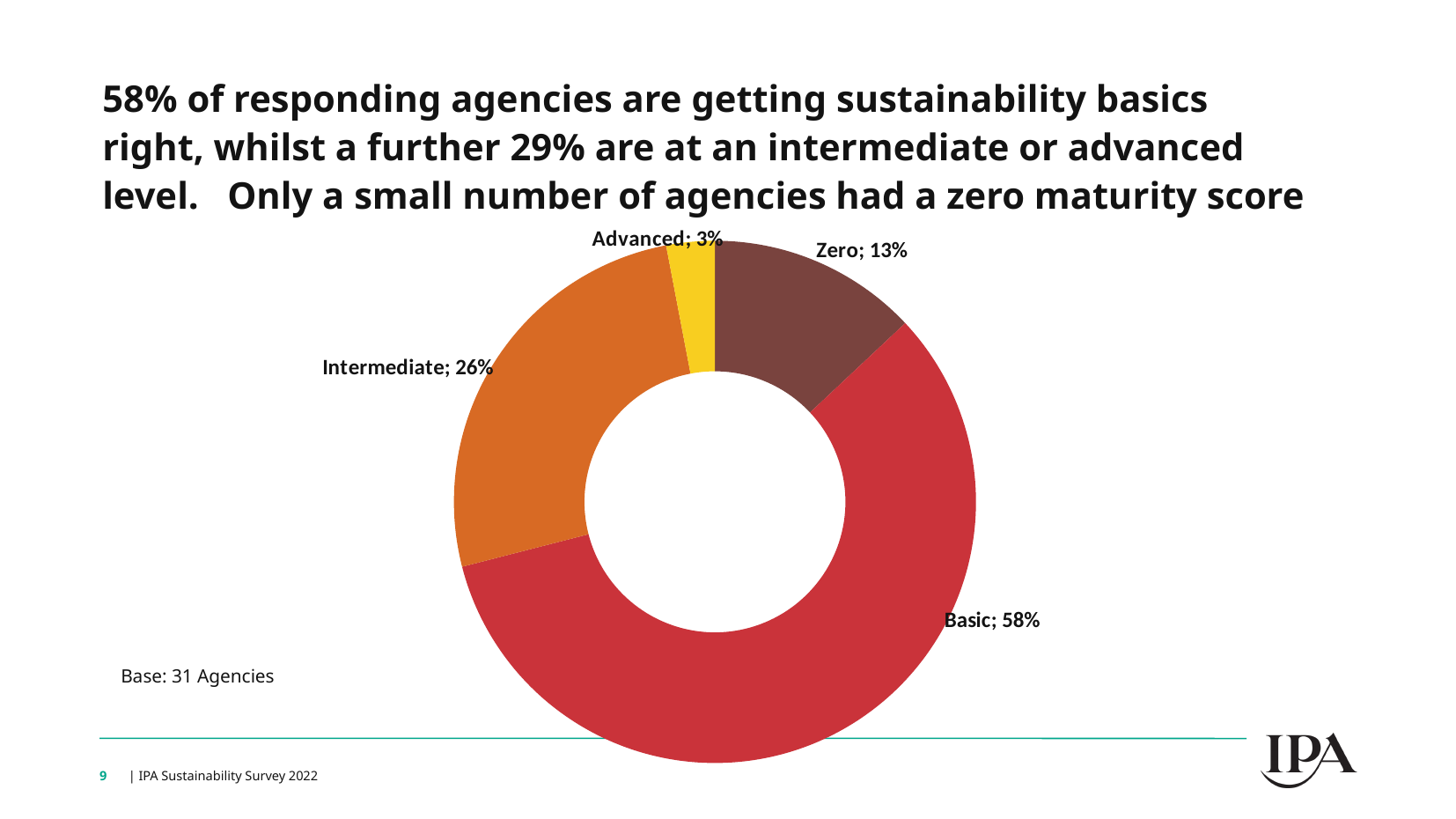
What is the difference in percentage points between the Basic and Intermediate shares? 32 Which maturity level has the smallest share of agencies? Advanced What percentage of agencies are at the Basic maturity level? 58% What kind of chart is shown on the slide? Doughnut chart What percentage of agencies are at the Intermediate maturity level? 26% How many maturity levels are shown in the chart? 4 Which maturity level has the largest share of agencies? Basic What is the difference in percentage points between the Zero and Advanced shares? 10 Which is larger, the share for Intermediate or the share for Zero? Intermediate What percentage of agencies are at the Advanced maturity level? 3% What percentage of agencies have a Zero maturity score? 13% What is the base (number of agencies) stated for the chart? 31 Agencies